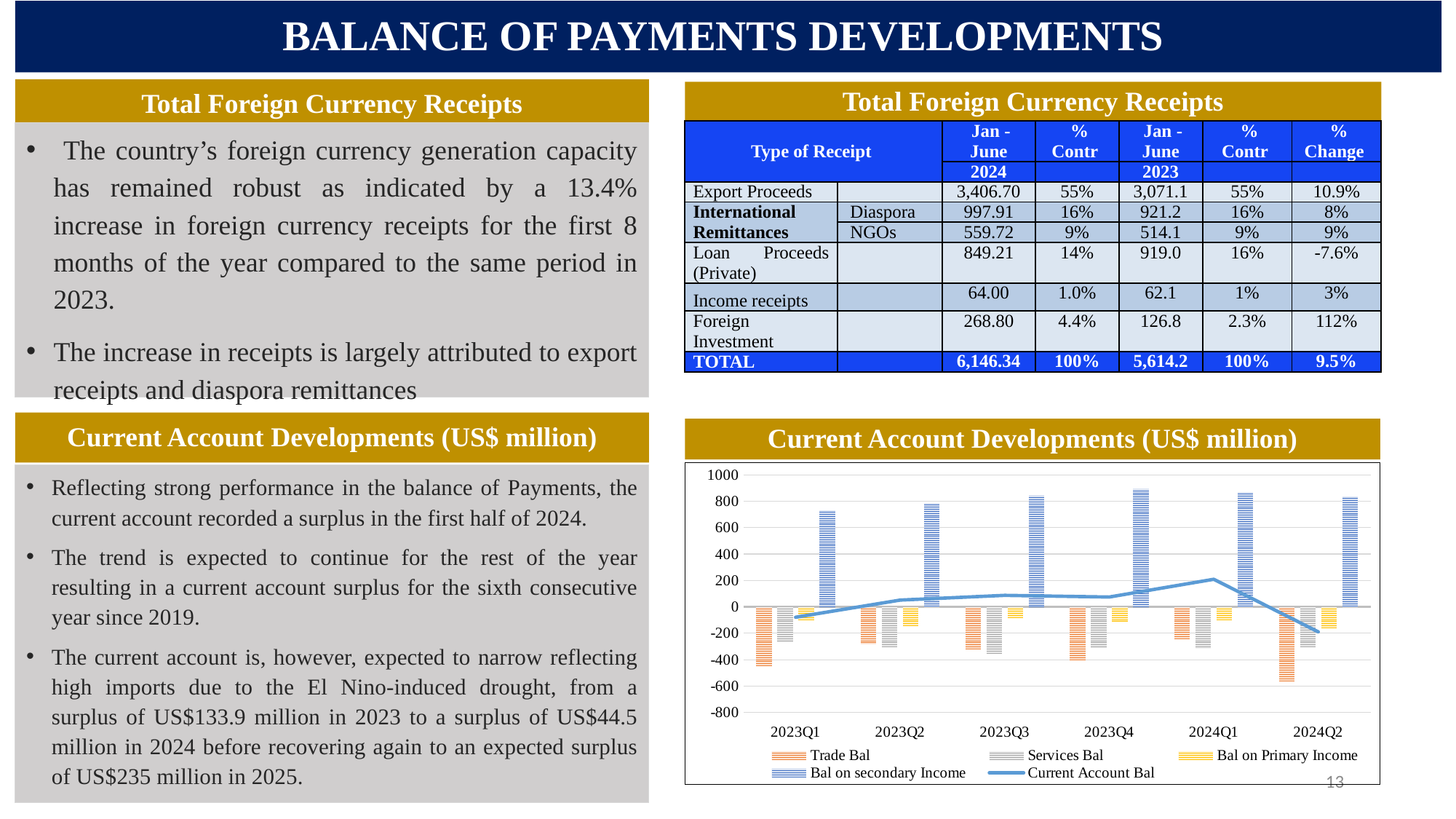
In the Current Account Developments chart, is the Bal on secondary Income for 2023Q4 greater or less than 800? greater How many series does the legend of the Current Account Developments chart list? 5 What kind of chart is shown under "Current Account Developments (US$ million)"? A combined bar and line chart In the Current Account Developments chart, in which quarter is the Trade Bal most negative? 2024Q2 In the Current Account Developments chart, is the Trade Bal for 2024Q2 greater or less than -400? less In the Current Account Developments chart, in which quarter is the Current Account Bal highest? 2024Q1 In the Current Account Developments chart, which is larger: the Trade Bal for 2023Q3 or the Trade Bal for 2024Q2? 2023Q3 In the Current Account Developments chart, which series is drawn as a line rather than bars? Current Account Bal How many quarters are shown on the x axis of the Current Account Developments chart? 6 In the Current Account Developments chart, in which quarter is the Current Account Bal lowest? 2024Q2 In the Current Account Developments chart, does the Current Account Bal rise or fall from 2024Q1 to 2024Q2? fall In the Current Account Developments chart, is the Current Account Bal for 2024Q2 greater or less than 0? less